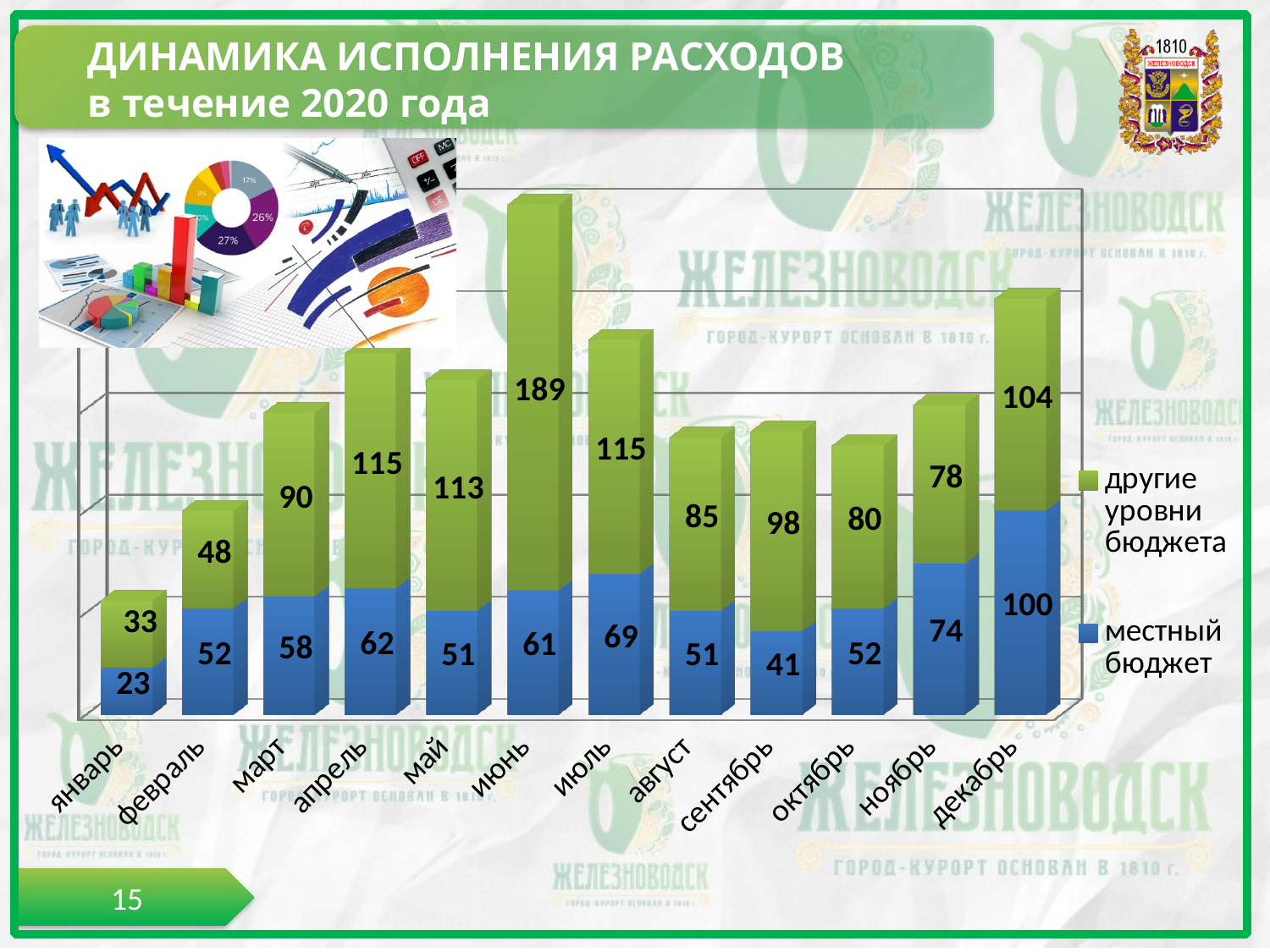
What kind of chart is shown on the slide? stacked bar chart What is the total of the stacked bar for январь? 56 How many months (categories) are shown on the x axis? 12 Which month has the highest value for 'другие уровни бюджета'? июнь Which is larger: the 'местный бюджет' value for ноябрь or for октябрь? ноябрь Which colour represents 'местный бюджет' in the chart? blue What is the value of 'другие уровни бюджета' for сентябрь? 98 What is the total of the stacked bar for декабрь? 204 What is the value of 'местный бюджет' for июнь? 61 How many series does the legend list? 2 What is the difference between the 'другие уровни бюджета' values for июнь and июль? 74 Which month has the lowest value for 'местный бюджет'? январь